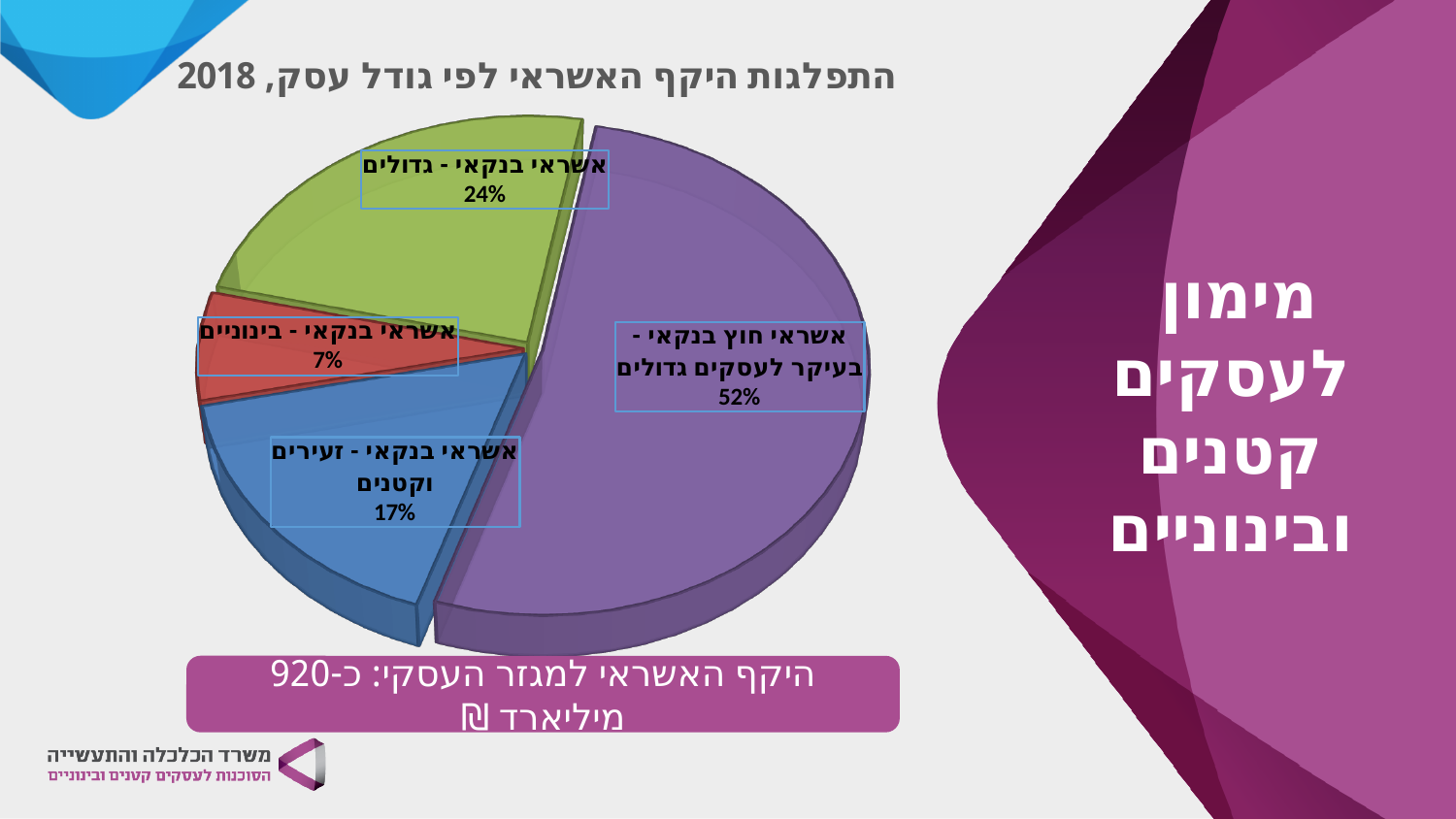
What is the difference in percentage points between "אשראי בנקאי - גדולים" and "אשראי בנקאי - זעירים וקטנים"? 7 What percentage is shown for "אשראי בנקאי - גדולים"? 24% Which is larger: the share for "אשראי בנקאי - זעירים וקטנים" or the share for "אשראי בנקאי - בינוניים"? אשראי בנקאי - זעירים וקטנים What percentage is shown for "אשראי בנקאי - זעירים וקטנים"? 17% What is the title of the chart? התפלגות היקף האשראי לפי גודל עסק, 2018 How many slices does the pie chart have? 4 Which slice of the pie is the smallest? אשראי בנקאי - בינוניים What percentage is shown for "אשראי בנקאי - בינוניים"? 7% What share of the pie is labelled "אשראי חוץ בנקאי - בעיקר לעסקים גדולים"? 52% What colour is the slice for "אשראי חוץ בנקאי - בעיקר לעסקים גדולים"? Purple What kind of chart is shown on the slide? Pie chart Which slice of the pie is the largest? אשראי חוץ בנקאי - בעיקר לעסקים גדולים